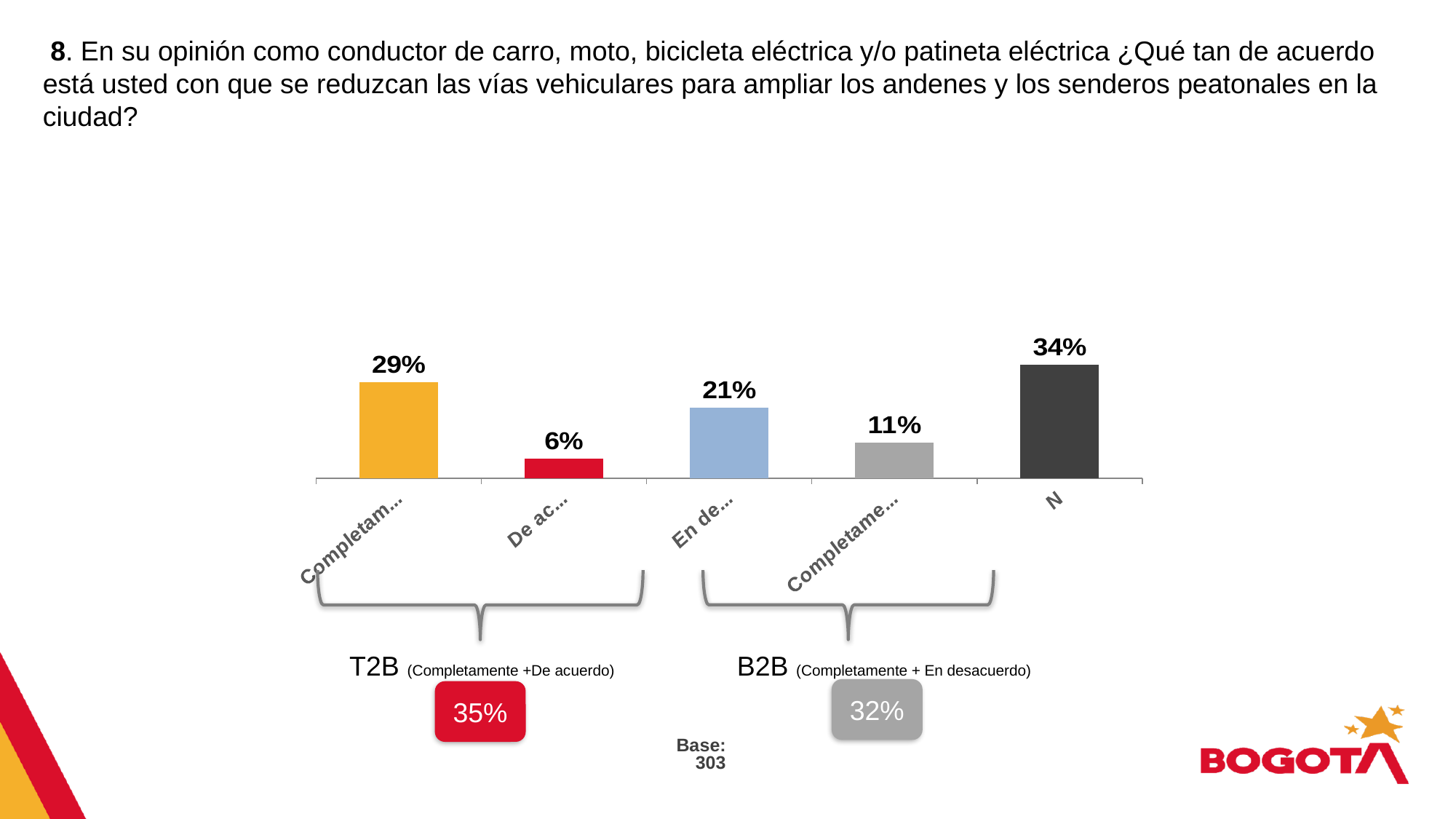
Which bar has the lowest value in the chart? the red bar, second from the left (6%) What is the value shown on the light blue bar in the middle of the chart? 21% What type of chart is shown on the slide? bar chart What is the difference between the value of the far-right dark bar and the first orange bar? 5% What T2B (Completamente + De acuerdo) value is shown below the chart? 35% Which is larger, the value of the light blue bar or the grey bar next to it? the light blue bar (21%) What is the value shown on the grey bar, the fourth from the left? 11% What is the value shown on the first (orange) bar from the left? 29% What is the value shown on the dark bar at the far right of the chart? 34% Which bar has the highest value in the chart? the dark bar at the far right (34%) What is the value shown on the red bar, the second from the left? 6% How many bars are plotted in the chart? 5